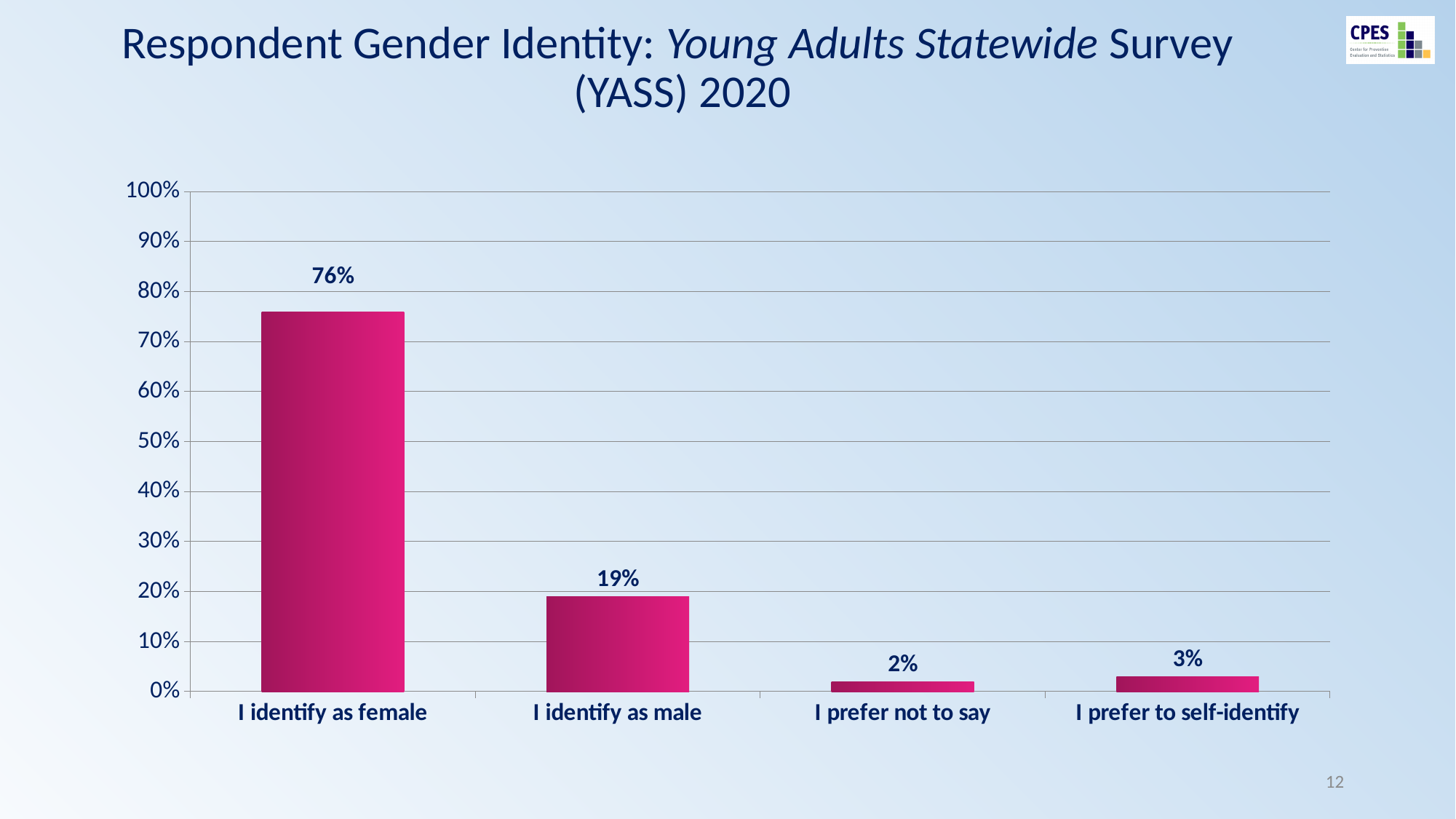
What percentage of respondents selected "I identify as male"? 19% Which is larger: the value for "I prefer to self-identify" or the value for "I prefer not to say"? I prefer to self-identify What is the title of the slide? Respondent Gender Identity: Young Adults Statewide Survey (YASS) 2020 What percentage of respondents selected "I prefer to self-identify"? 3% What kind of chart is shown on the slide? Bar chart What percentage of respondents selected "I prefer not to say"? 2% Is the value for "I identify as male" greater or less than 20%? less What is the difference in percentage points between "I identify as female" and "I identify as male"? 57 Which response category has the lowest percentage? I prefer not to say Which response category has the highest percentage? I identify as female How many response categories are shown on the x axis? 4 What percentage of respondents selected "I identify as female"? 76%